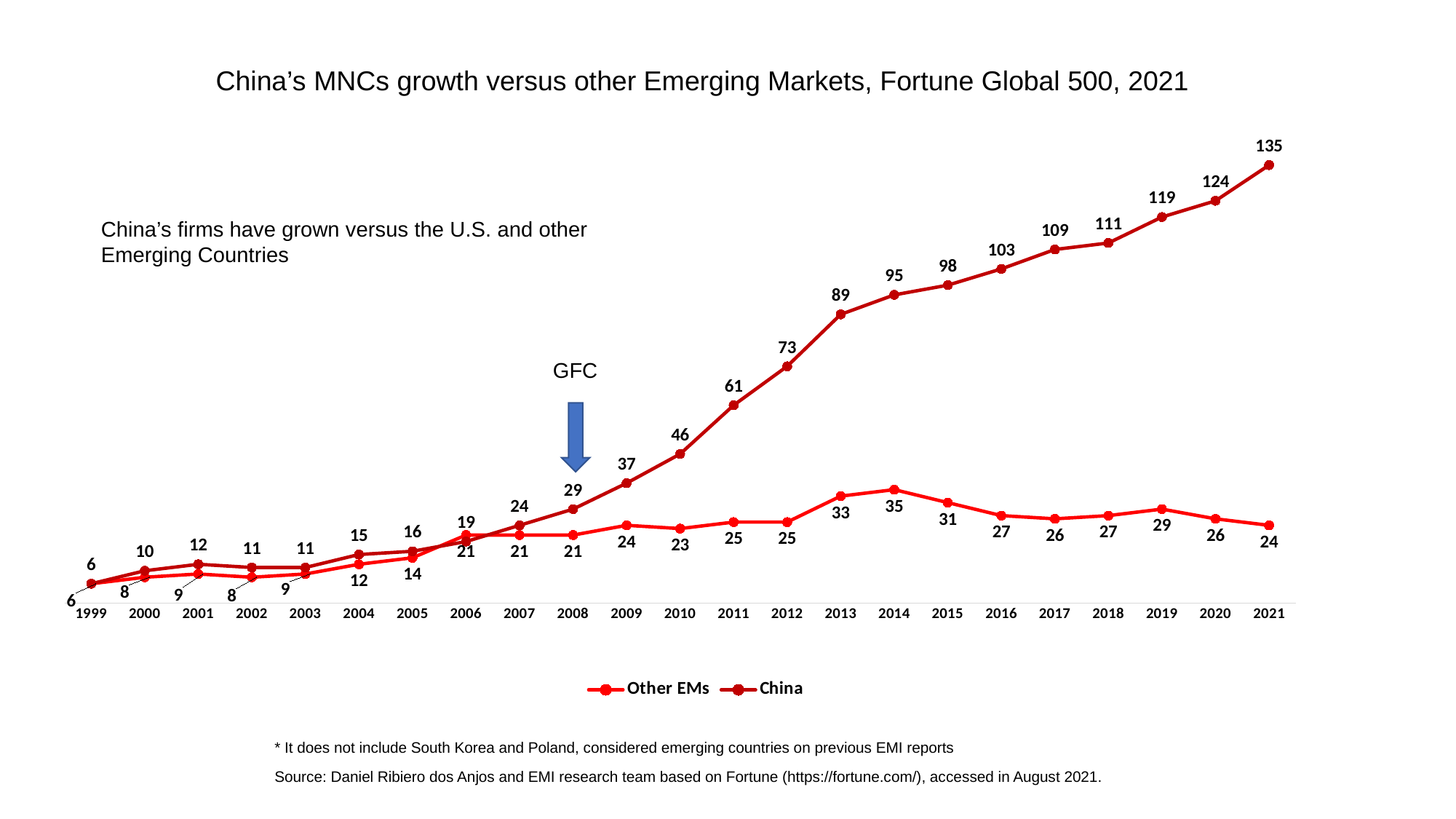
What is the value for China in 2021? 135 What is the value for Other EMs in 2014? 35 What is the difference between China and Other EMs in 2021? 111 In which year does the Other EMs series reach its highest value? 2014 How many years are plotted along the x axis? 23 In 2013, which series has the larger value, China or Other EMs? China How many series does the legend list? 2 What kind of chart is shown on the slide? Line chart In which year does the China series reach its highest value? 2021 What is the value for China in 2008, the year marked GFC? 29 Does the China series generally rise or fall from 2008 to 2021? Rise In which year is the China series at its lowest value? 1999